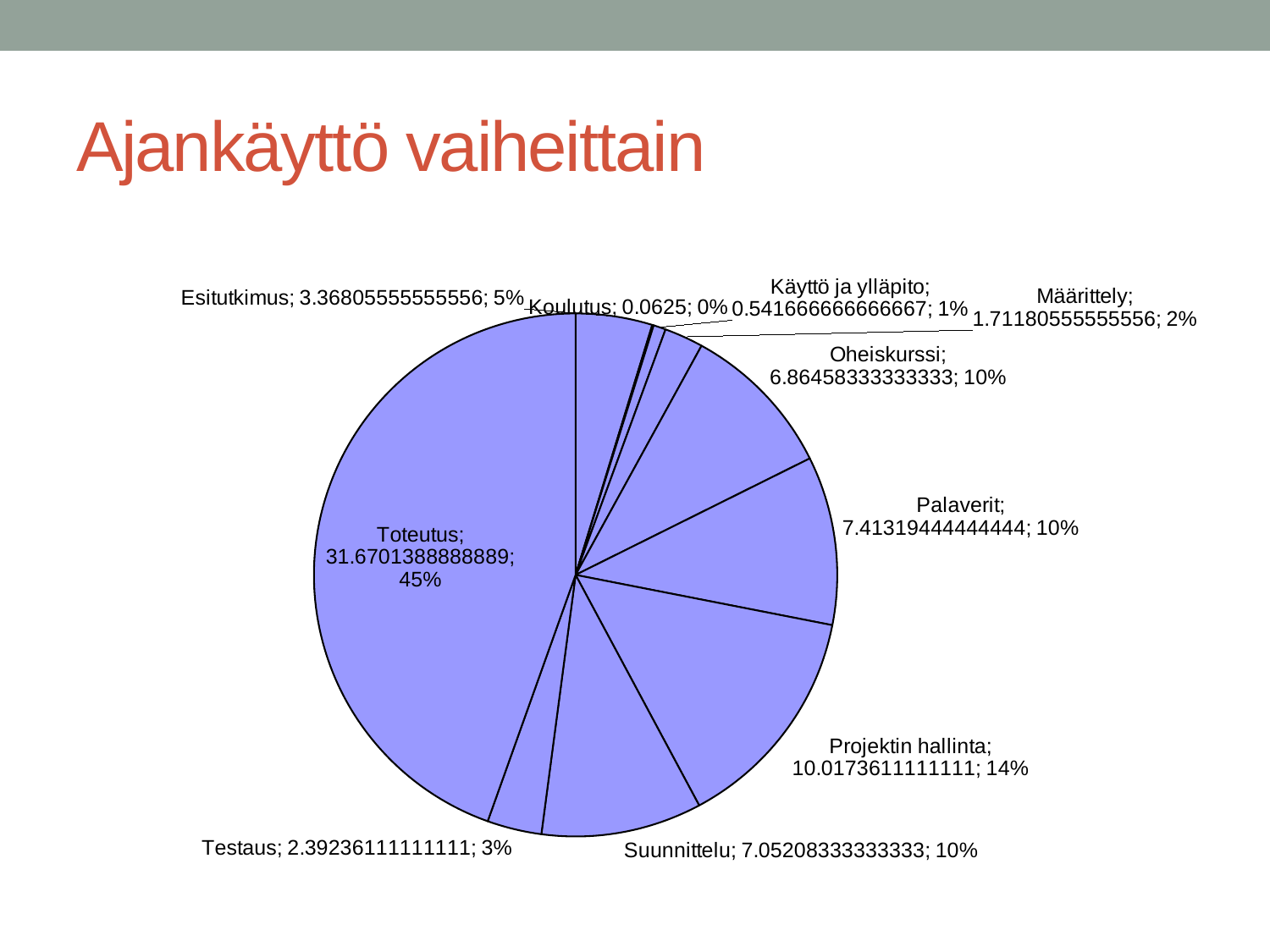
Which is larger, the slice for Palaverit or the slice for Määrittely? Palaverit What percentage share does Testaus have? 3% How many slices does the pie chart have? 10 What is the value shown for Projektin hallinta? 10.0173611111111 Which category has the smallest slice in the pie chart? Koulutus What percentage share does Esitutkimus have? 5% What is the title of the chart on the slide? Ajankäyttö vaiheittain What kind of chart is shown on the slide? pie chart What percentage share does Projektin hallinta have? 14% Which category has the largest slice in the pie chart? Toteutus What is the value shown for Koulutus? 0.0625